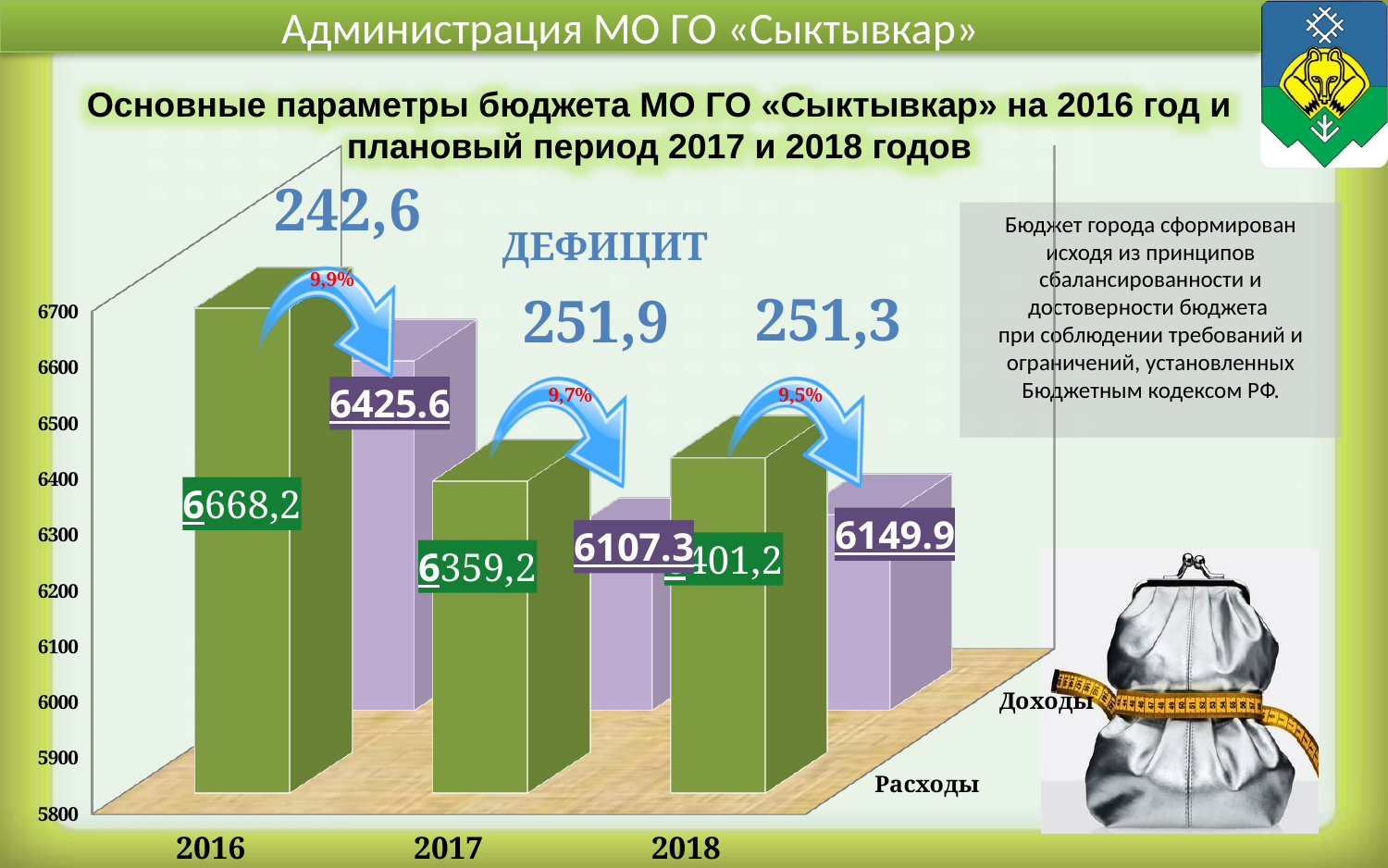
What is the value of Доходы for 2017? 6107.3 What is the value of Расходы for 2017? 6359,2 How many data series does the chart show? 2 What is the difference between Расходы and Доходы in 2016? 242,6 What kind of chart is shown on the slide? bar chart Which year has the highest Расходы value? 2016 Is the value of Расходы for 2018 greater or less than 6300? greater What is the value of Доходы for 2018? 6149.9 Which is larger in 2017, Расходы or Доходы? Расходы How many years are shown on the x axis? 3 What is the value of Расходы for 2016? 6668,2 Which year has the lowest Доходы value? 2017